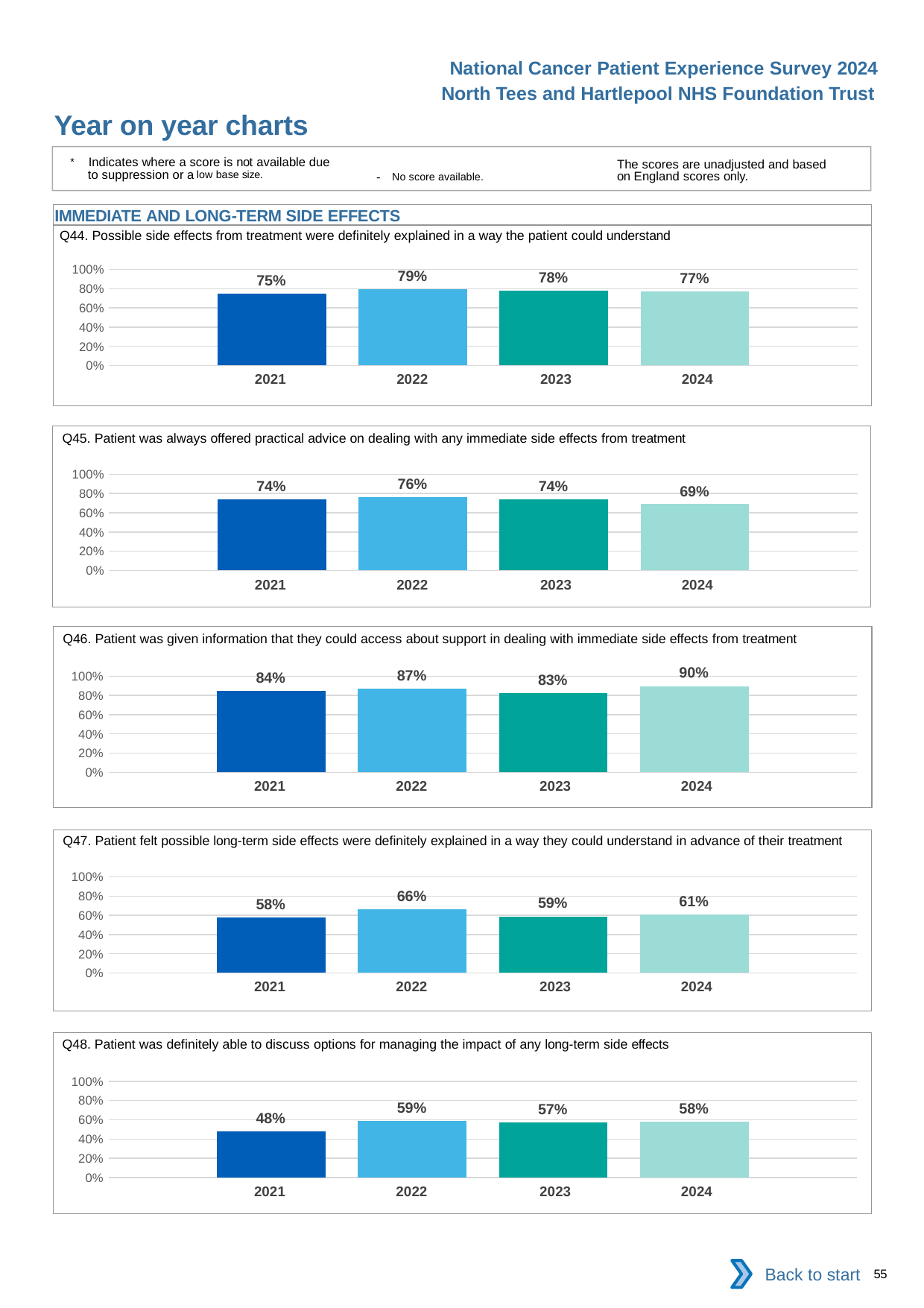
In the Q48 chart, is the value for 2021 greater or less than 60%? less In the Q48 chart, what is the value for 2021? 48% What kind of chart is the Q46 chart? bar chart In the Q45 chart, which is larger, the value for 2022 or the value for 2024? 2022 How many years are shown in the Q44 chart? 4 In the Q44 chart, what is the value for 2022? 79% In the Q46 chart, which year has the highest value? 2024 In the Q45 chart, which year has the lowest value? 2024 In the Q46 chart, what is the difference between the 2024 and 2023 values? 7% In the Q47 chart, what is the value for 2024? 61% In the Q47 chart, what is the difference between the 2022 and 2021 values? 8% How many charts are shown on the slide? 5